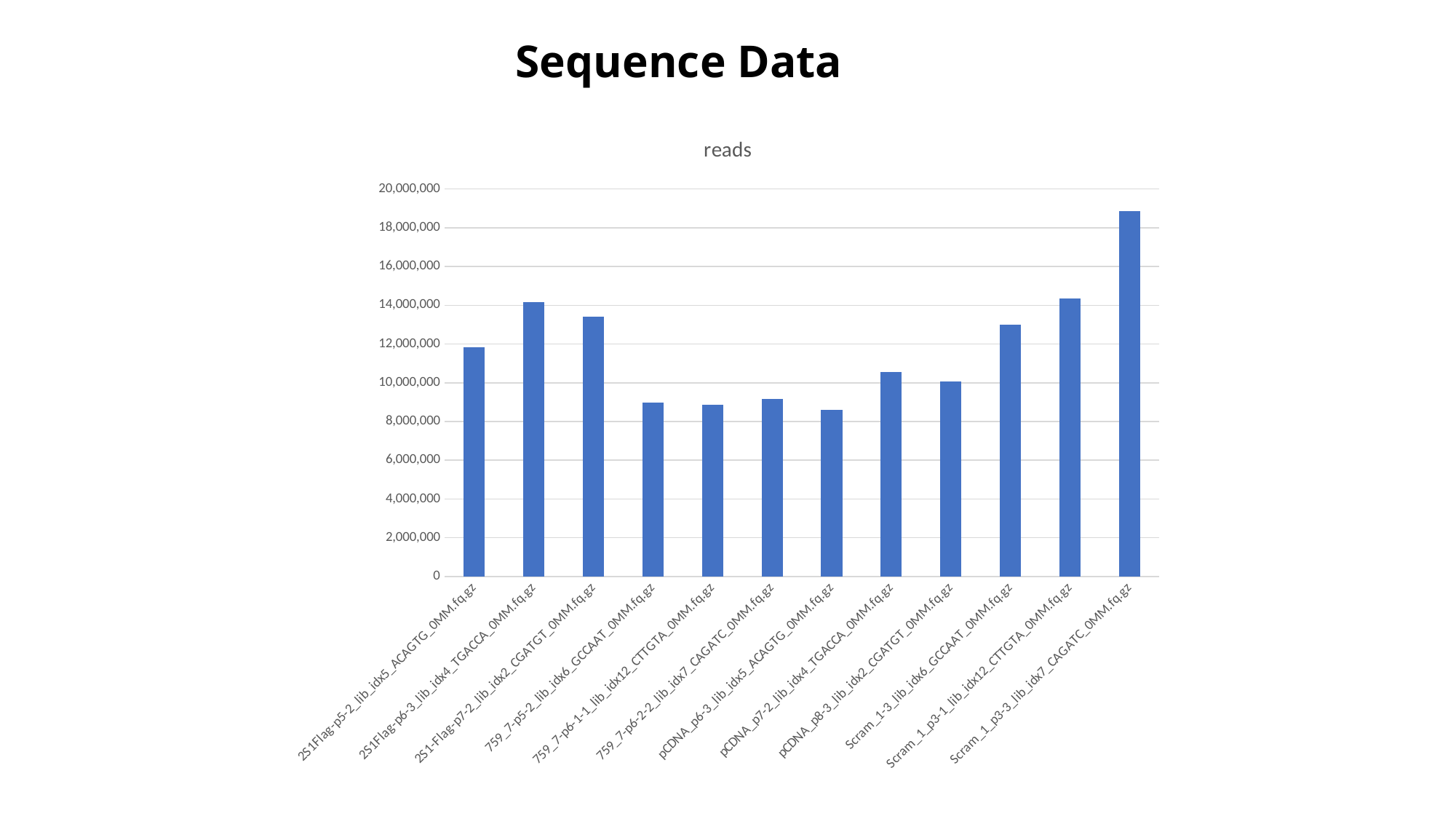
Is the value for 759_7-p5-2_lib_idx6_GCCAAT_0MM.fq.gz greater or less than 8,000,000? greater Is the value for Scram_1_p3-3_lib_idx7_CAGATC_0MM.fq.gz greater or less than 18,000,000? greater How many bars (categories) does the chart show? 12 Which has more reads: Scram_1-3_lib_idx6_GCCAAT_0MM.fq.gz or 759_7-p6-2-2_lib_idx7_CAGATC_0MM.fq.gz? Scram_1-3_lib_idx6_GCCAAT_0MM.fq.gz Which has more reads: 2S1-Flag-p7-2_lib_idx2_CGATGT_0MM.fq.gz or pCDNA_p7-2_lib_idx4_TGACCA_0MM.fq.gz? 2S1-Flag-p7-2_lib_idx2_CGATGT_0MM.fq.gz Which category has the highest number of reads? Scram_1_p3-3_lib_idx7_CAGATC_0MM.fq.gz What is the title of the chart? reads Is the value for pCDNA_p6-3_lib_idx5_ACAGTG_0MM.fq.gz greater or less than 10,000,000? less What is the maximum value shown on the vertical axis? 20,000,000 What kind of chart is shown on the slide? bar chart